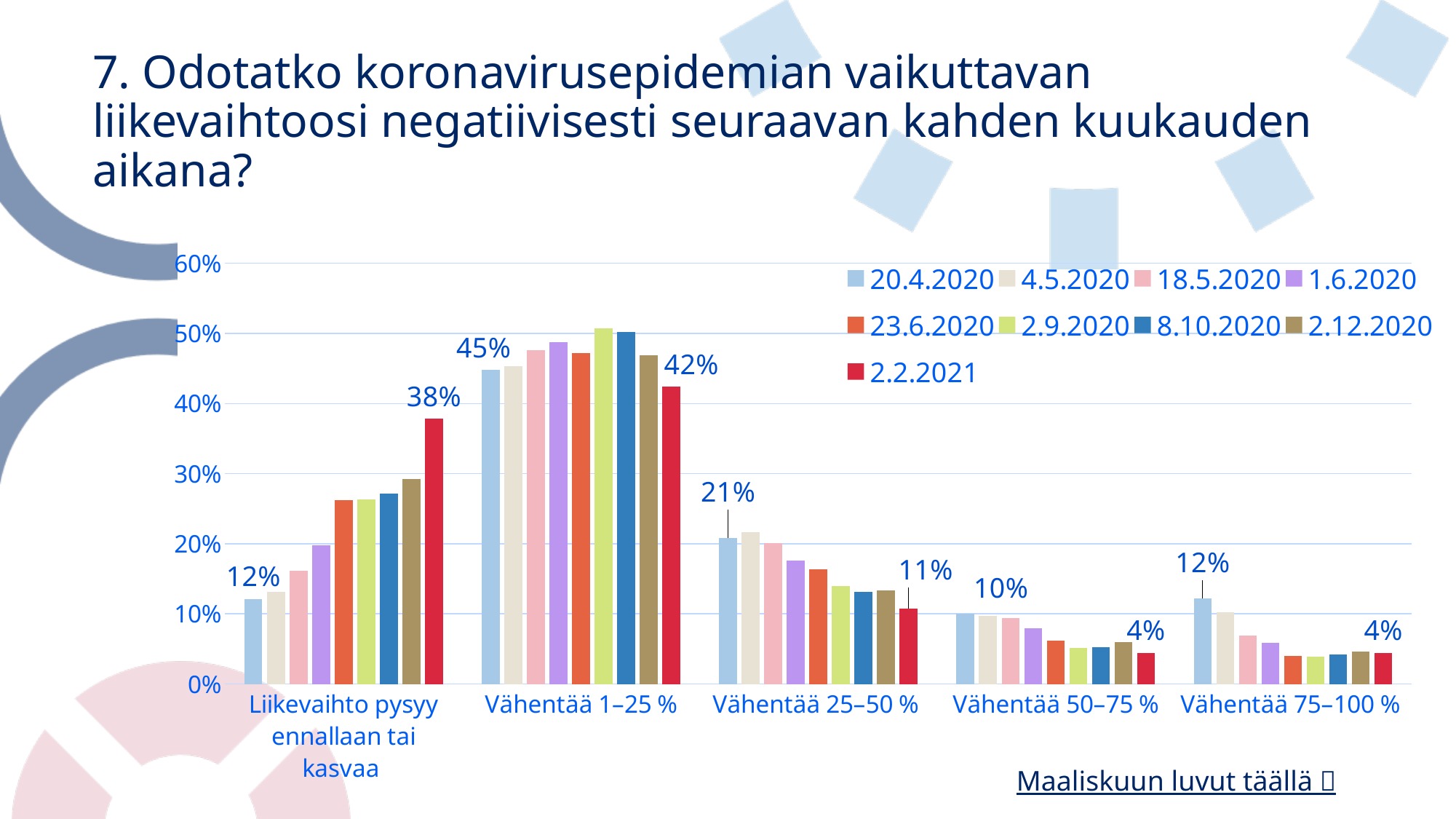
How many series does the legend list? 9 In the category "Vähentää 25–50 %", which is larger: the value for 20.4.2020 or for 2.2.2021? 20.4.2020 What is the value for 2.2.2021 in the category "Vähentää 25–50 %"? 11% What is the value for 20.4.2020 in the category "Vähentää 1–25 %"? 45% Which category has the highest value for the 2.2.2021 series? Vähentää 1–25 % What kind of chart is shown on the slide? Bar chart Is the value for 23.6.2020 in the category "Liikevaihto pysyy ennallaan tai kasvaa" greater or less than 20%? greater What is the value for 2.2.2021 in the category "Liikevaihto pysyy ennallaan tai kasvaa"? 38% What is the difference between the 20.4.2020 and 2.2.2021 values in the category "Vähentää 1–25 %"? 3 percentage points What is the difference between the 2.2.2021 and 20.4.2020 values in the category "Liikevaihto pysyy ennallaan tai kasvaa"? 26 percentage points What is the value for 20.4.2020 in the category "Liikevaihto pysyy ennallaan tai kasvaa"? 12% What is the value for 2.2.2021 in the category "Vähentää 75–100 %"? 4%